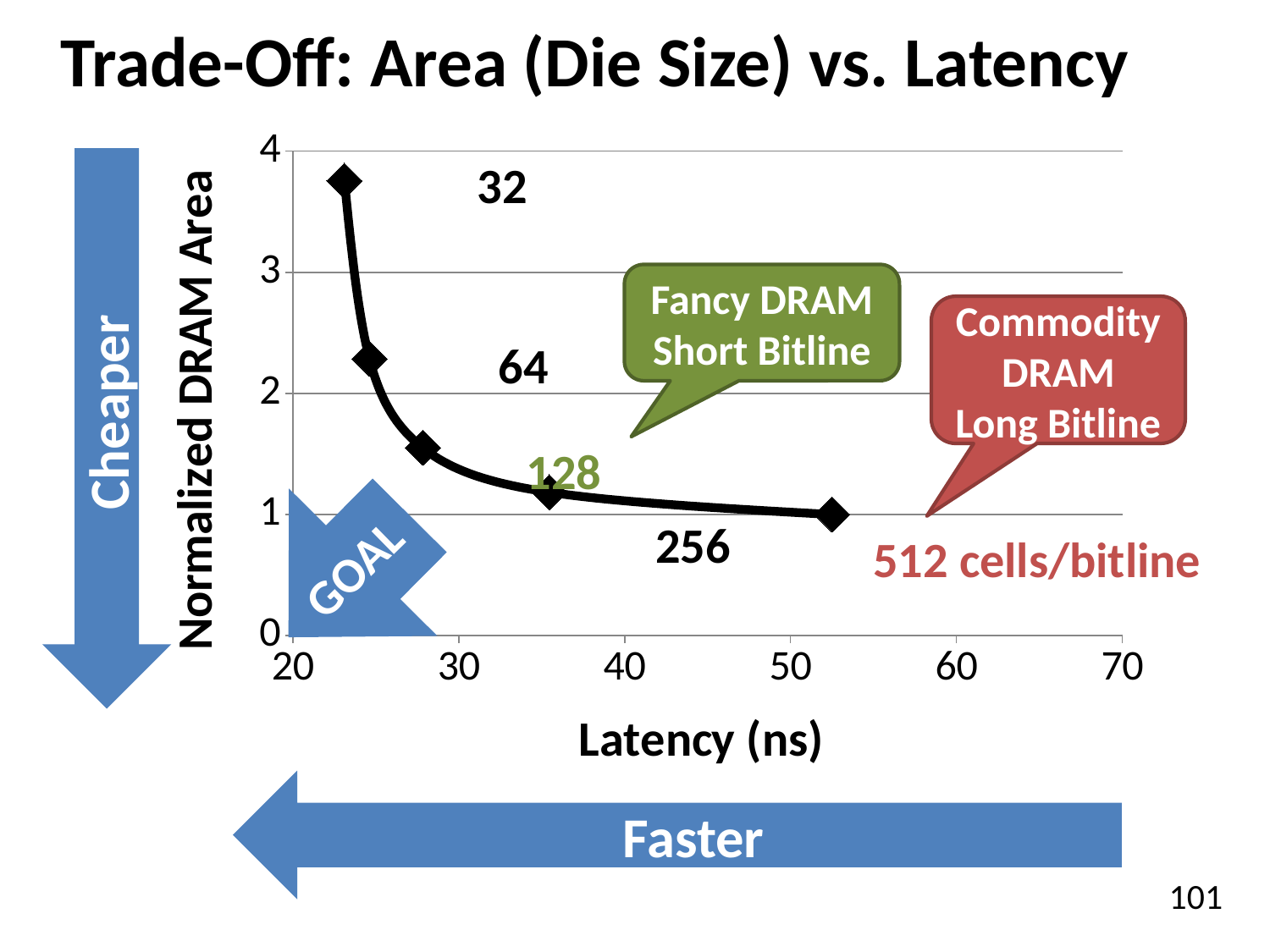
Which has the larger normalized DRAM area, 64 cells/bitline or 256 cells/bitline? 64 cells/bitline Is the latency for 512 cells/bitline greater or less than 50 ns? greater Is the normalized DRAM area for 128 cells/bitline greater or less than 2? less Which cells/bitline configuration has the highest latency? 512 What is the title of the chart's y axis? Normalized DRAM Area What is the title of the chart's x axis? Latency (ns) Is the normalized DRAM area for 32 cells/bitline greater or less than 3? greater How many data points are plotted on the chart? 5 As latency increases along the x axis, does the normalized DRAM area rise or fall? fall Which cells/bitline configuration has the lowest latency? 32 Which cells/bitline configuration has the highest normalized DRAM area? 32 What kind of chart is shown on the slide? line chart